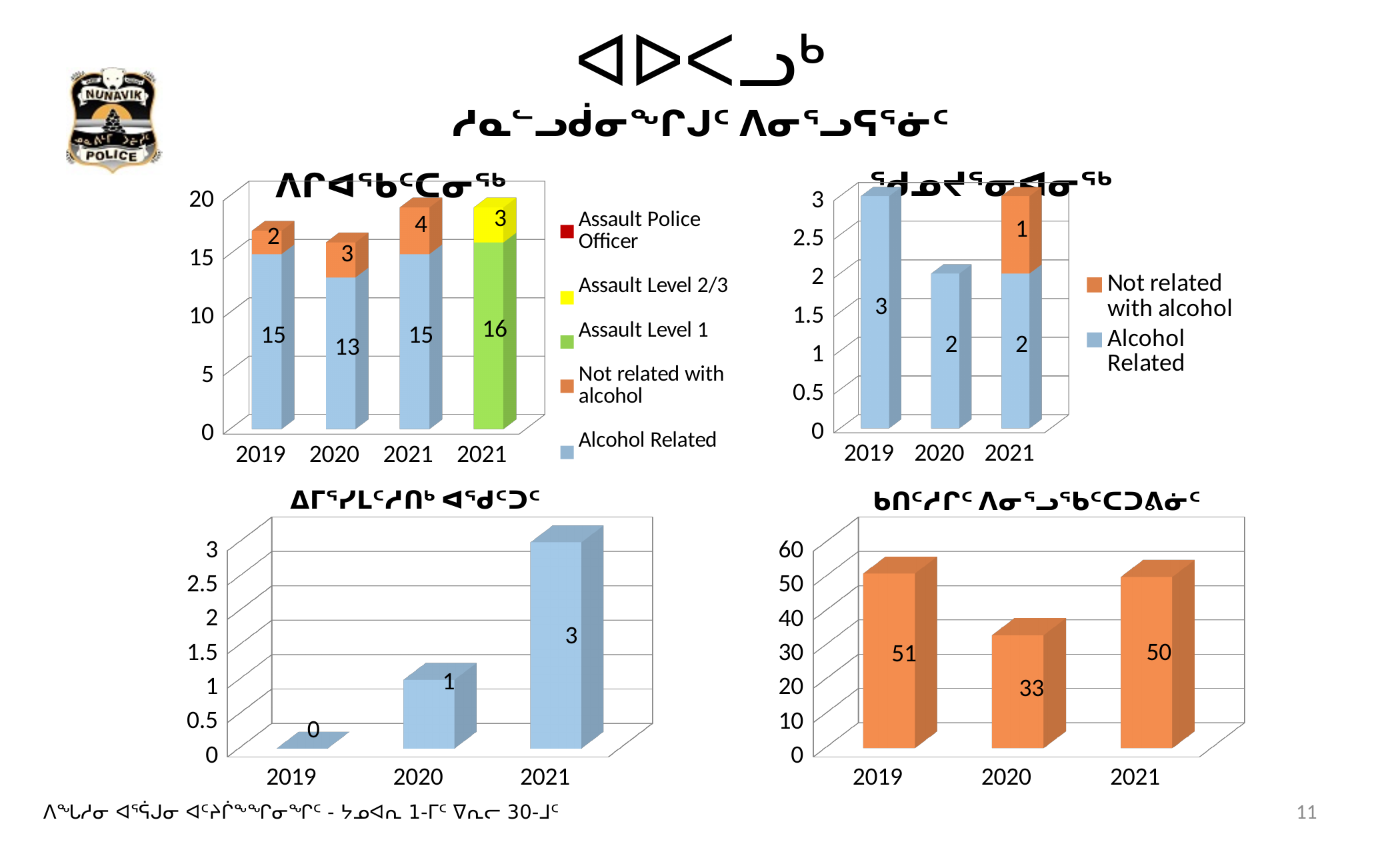
What kind of chart is the bottom-right chart? bar chart In the bottom-right chart, which year has the highest value? 2019 In the bottom-right chart, what is the difference between the values for 2019 and 2020? 18 In the top-left chart, how many series does the legend list? 5 In the top-left chart, what is the total of the stacked bar for the first 2021 bar (Alcohol Related plus Not related with alcohol)? 19 In the bottom-left chart, do the values rise or fall from 2019 to 2021? rise In the bottom-left chart, what is the value for 2021? 3 In the bottom-left chart, which year has the lowest value? 2019 In the bottom-right chart, what is the value for 2020? 33 In the top-right chart, what is the Not related with alcohol value for 2021? 1 In the top-right chart, how many years are shown on the x axis? 3 In the top-left chart, what is the Alcohol Related value for 2020? 13